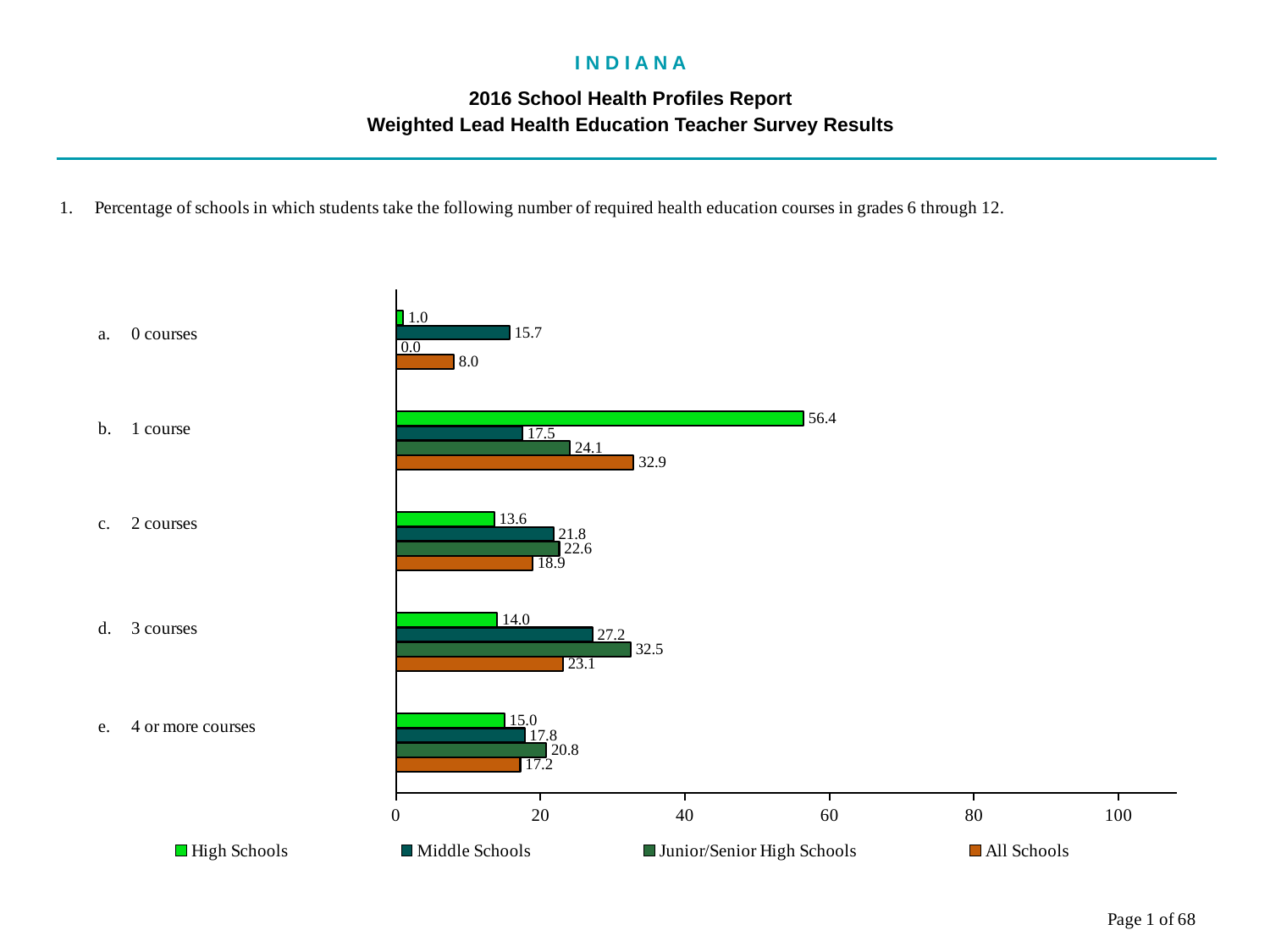
What is the value for All Schools in the '0 courses' category? 8.0 What is the value for Junior/Senior High Schools in the '3 courses' category? 32.5 Which is larger: the Middle Schools value for '3 courses' or the Middle Schools value for '4 or more courses'? 3 courses Which category has the highest value for High Schools? 1 course What is the value for High Schools in the '1 course' category? 56.4 What is the difference between the All Schools values for '1 course' and '2 courses'? 14.0 Which series is shown in orange in the legend? All Schools What kind of chart is shown on the slide? bar chart Which category has the lowest value for Middle Schools? 0 courses How many series does the legend list? 4 Is the value for High Schools in the '1 course' category greater or less than 40? greater How many categories are shown on the chart? 5